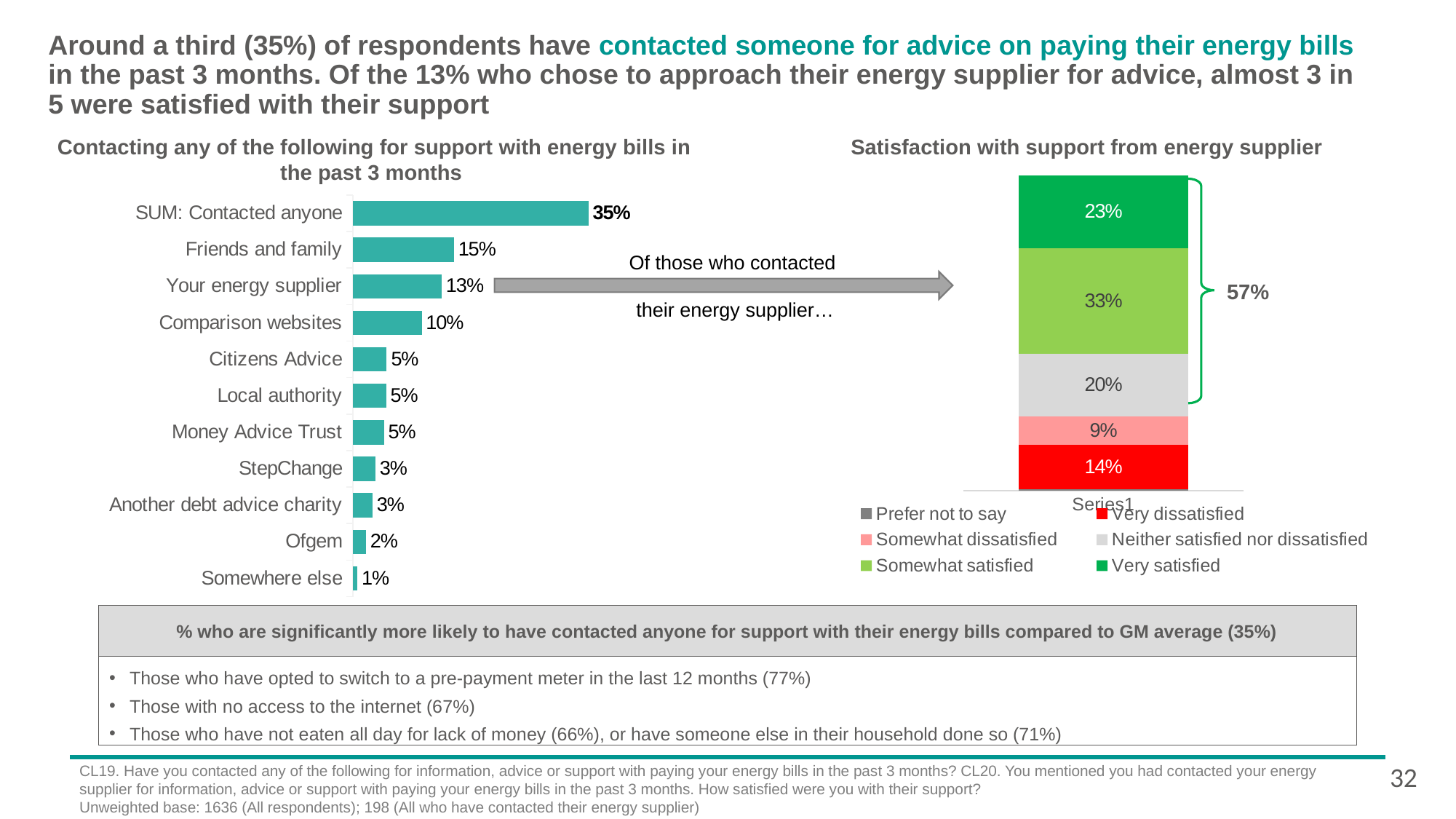
In the chart 'Satisfaction with support from energy supplier', which segment is the largest? Somewhat satisfied In the chart 'Contacting any of the following for support with energy bills in the past 3 months', what is the difference between Friends and family and Comparison websites? 5% In the chart 'Satisfaction with support from energy supplier', what is the value for Very dissatisfied? 14% In the chart 'Contacting any of the following for support with energy bills in the past 3 months', what is the value for Your energy supplier? 13% In the chart 'Contacting any of the following for support with energy bills in the past 3 months', what is the value for Friends and family? 15% How many categories are shown in the chart 'Contacting any of the following for support with energy bills in the past 3 months'? 11 In the chart 'Contacting any of the following for support with energy bills in the past 3 months', which is larger: Comparison websites or Citizens Advice? Comparison websites In the chart 'Contacting any of the following for support with energy bills in the past 3 months', which category has the lowest value? Somewhere else How many entries does the legend of the chart 'Satisfaction with support from energy supplier' list? 6 In the chart 'Contacting any of the following for support with energy bills in the past 3 months', excluding the SUM bar, which source has the highest value? Friends and family What kind of chart is 'Contacting any of the following for support with energy bills in the past 3 months'? Bar chart In the chart 'Satisfaction with support from energy supplier', what is the value for Very satisfied? 23%